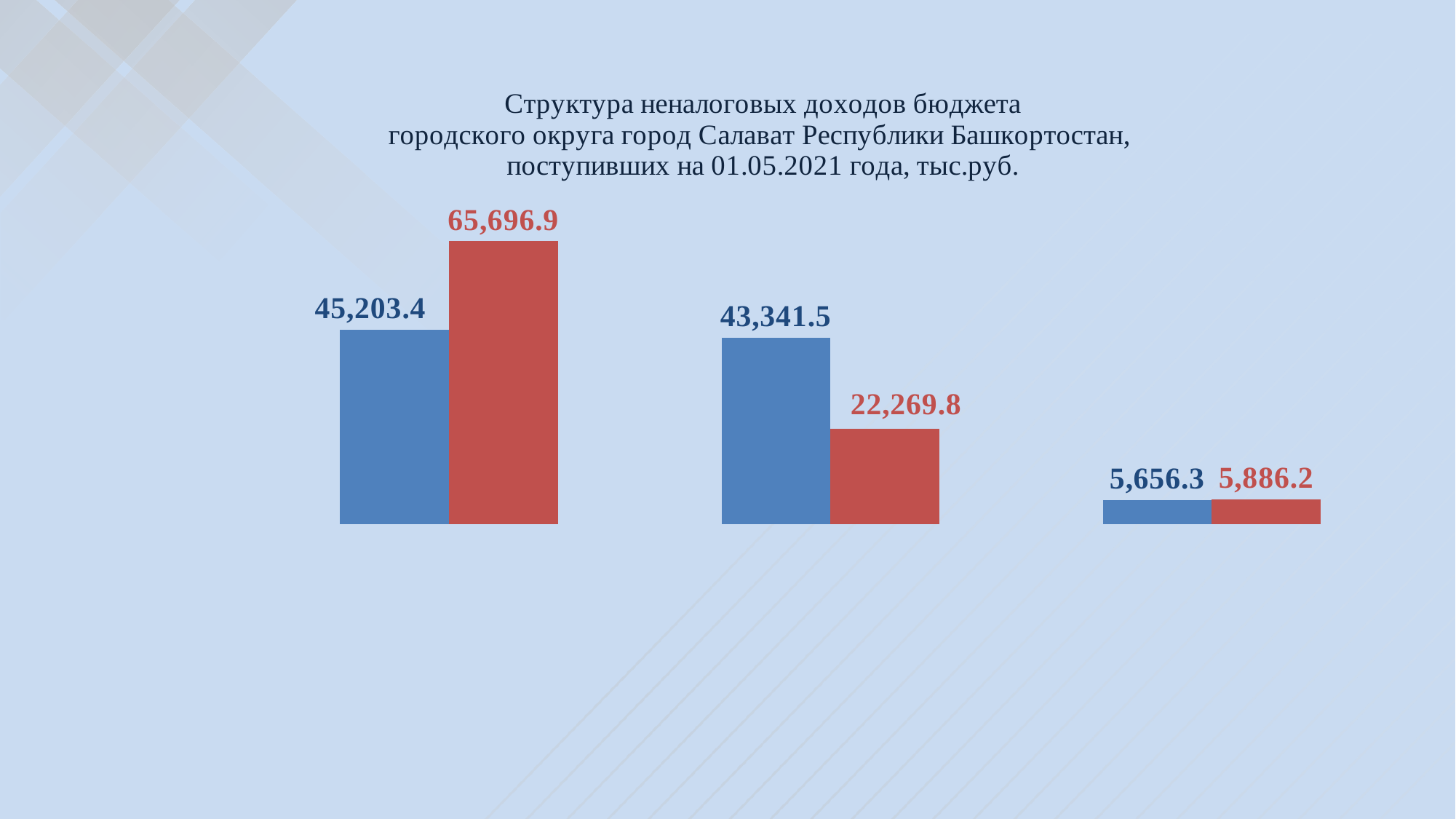
What is the difference between the red and blue bars in the middle group? 21,071.7 In the middle group, which bar is larger, the blue one or the red one? the blue one What is the value of the red bar in the left-hand group? 65,696.9 What kind of chart is shown on the slide? bar chart What is the value of the blue bar in the right-hand group? 5,656.3 Which bar has the lowest value on the chart? the blue bar in the right-hand group (5,656.3) Which bar has the highest value on the chart? the red bar in the left-hand group (65,696.9) What is the value of the blue bar in the left-hand group? 45,203.4 What is the value of the red bar in the middle group? 22,269.8 What is the value of the blue bar in the middle group? 43,341.5 How many groups of bars does the chart show? 3 What is the value of the red bar in the right-hand group? 5,886.2